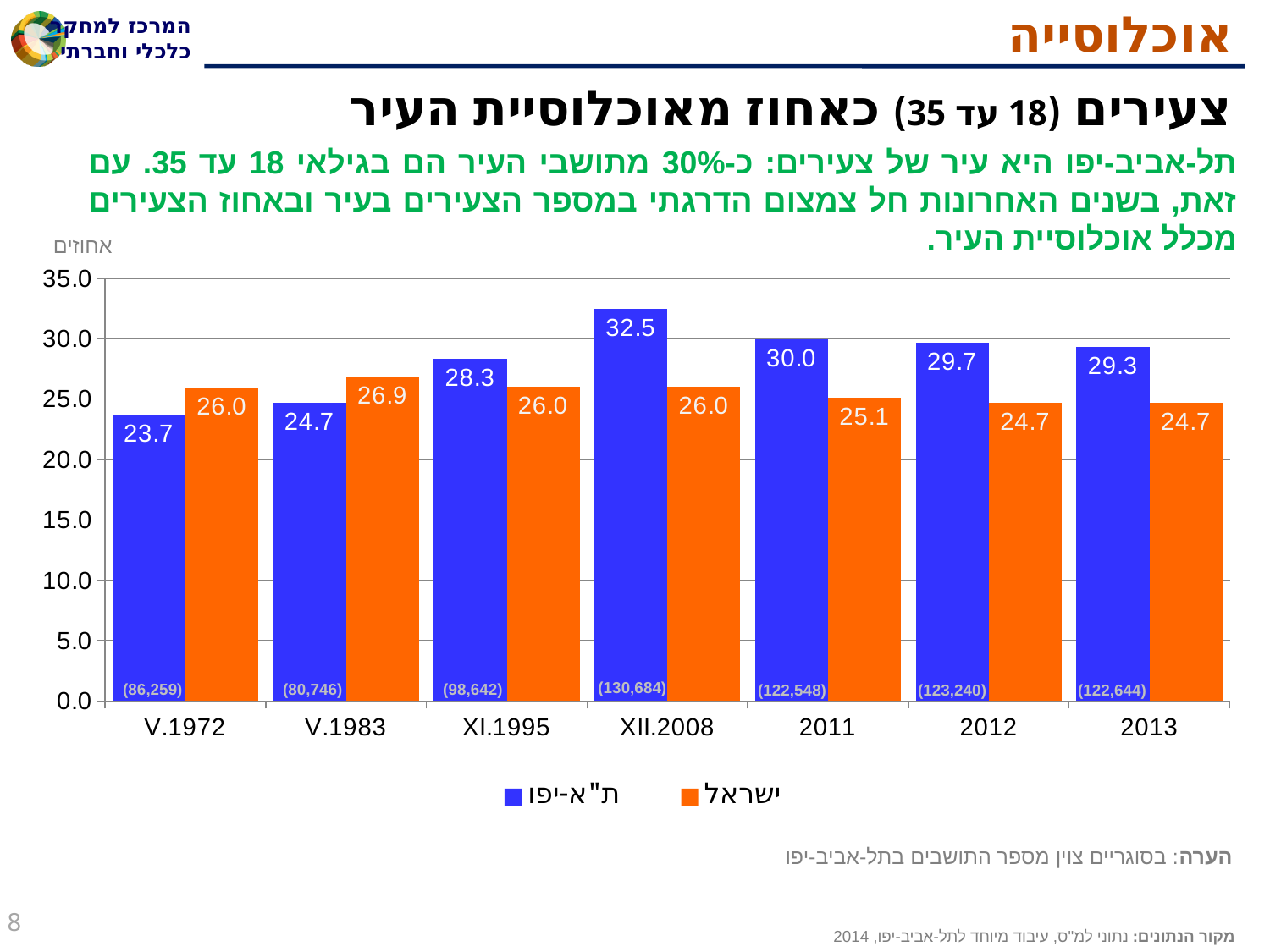
Does the ת"א-יפו value rise or fall from V.1972 to XII.2008? rise What is the value for ישראל in V.1983? 26.9 In which category is the ת"א-יפו value lowest? V.1972 How many categories are shown on the x axis? 7 What number is printed in parentheses at the base of the ת"א-יפו bar for XII.2008? (130,684) What is the value for ת"א-יפו in XII.2008? 32.5 What is the difference between the ת"א-יפו and ישראל values in 2011? 4.9 How many series does the legend list? 2 What type of chart is shown on the slide? bar chart What is the value for ת"א-יפו in 2013? 29.3 In V.1972, which series has the larger value, ת"א-יפו or ישראל? ישראל In which category is the ת"א-יפו value highest? XII.2008